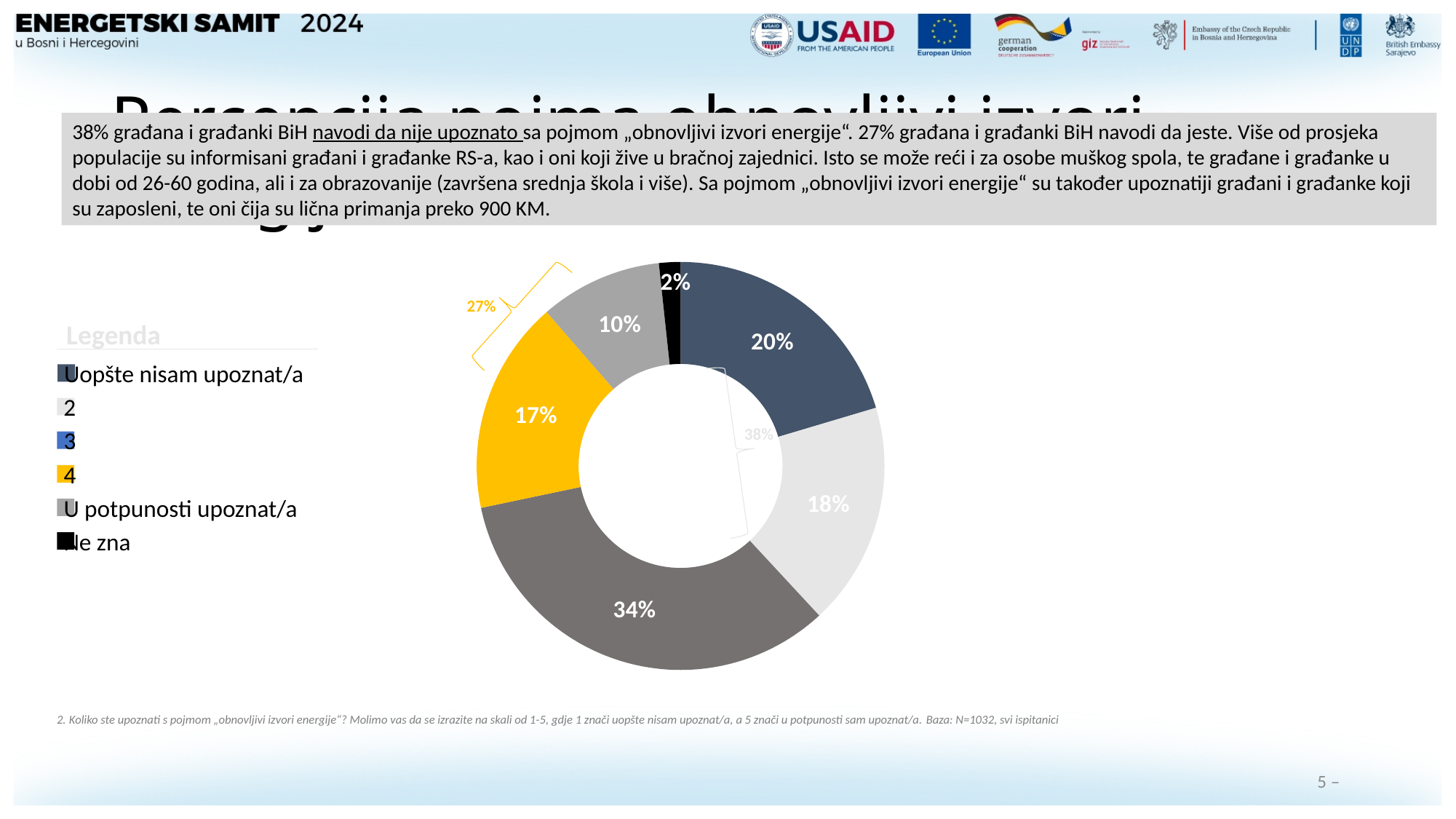
What percentage is shown for "Uopšte nisam upoznat/a"? 20% What is the difference between the slice for "Uopšte nisam upoznat/a" and the slice for "2"? 2 percentage points What combined percentage is marked by the bracket next to the yellow and gray slices on the left of the chart? 27% What percentage is shown for the category "4"? 17% Which category has the smallest slice in the chart? Ne zna What is the value of the largest slice in the chart? 34% Which is larger, the slice for "4" or the slice for "U potpunosti upoznat/a"? 4 What percentage is shown for "Ne zna"? 2% What percentage is shown for "U potpunosti upoznat/a"? 10% What percentage is shown for the category "2"? 18% What kind of chart is shown on the slide? Pie (donut) chart How many slices does the chart have? 6